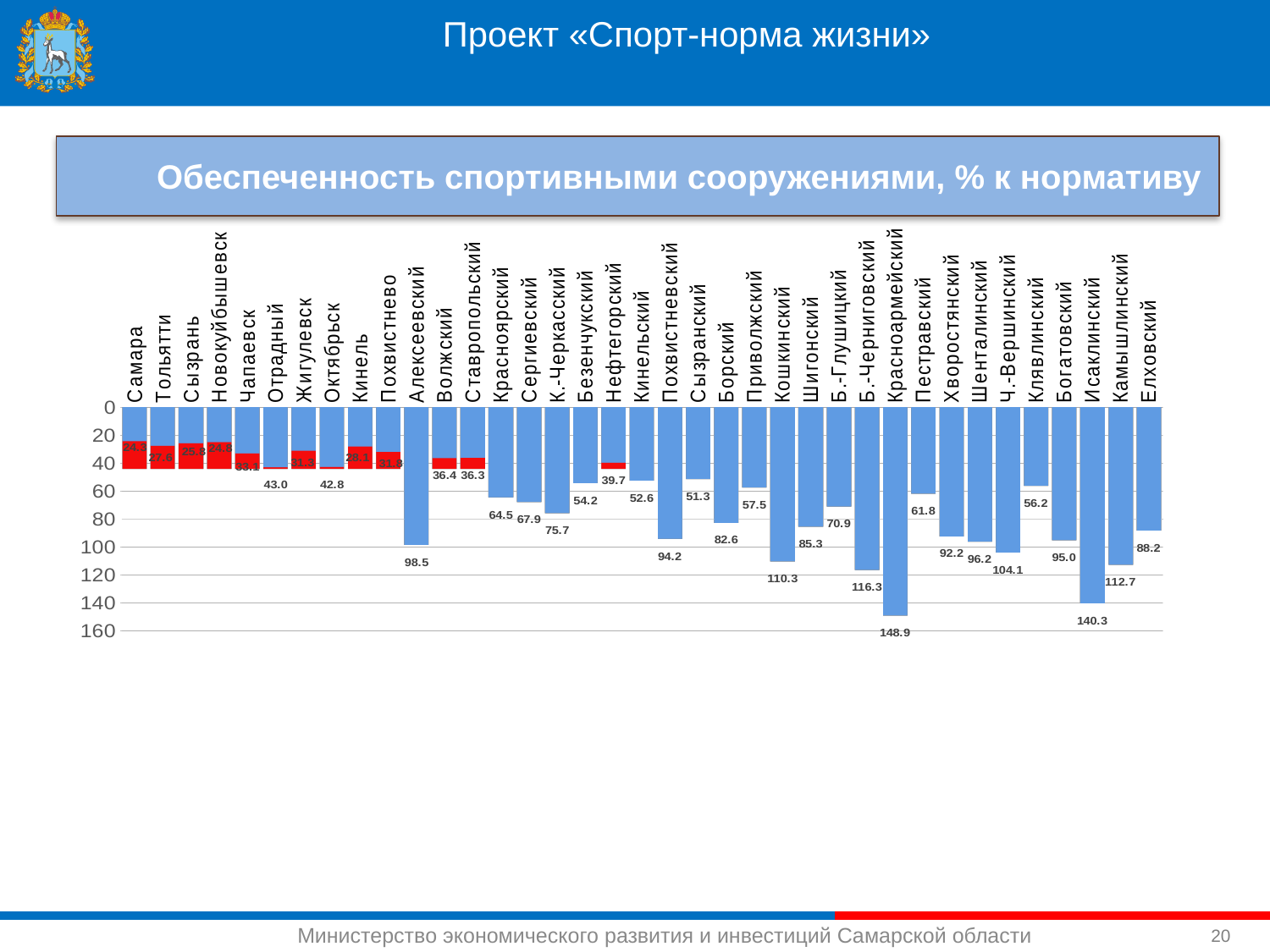
What kind of chart is shown on the slide? bar chart Which category has the highest value? Красноармейский What is the difference between the values for Сергиевский and Красноярский? 3.4 Which is larger, the value for Кошкинский or the value for Б.-Черниговский? Б.-Черниговский What is the value for Алексеевский? 98.5 What is the title of the chart? Обеспеченность спортивными сооружениями, % к нормативу What is the value for Елховский? 88.2 Is the value for Самара greater or less than 40? less How many categories are shown on the x axis? 37 What is the value for Красноармейский? 148.9 What is the value for Нефтегорский? 39.7 What is the difference between the values for Исаклинский and Камышлинский? 27.6